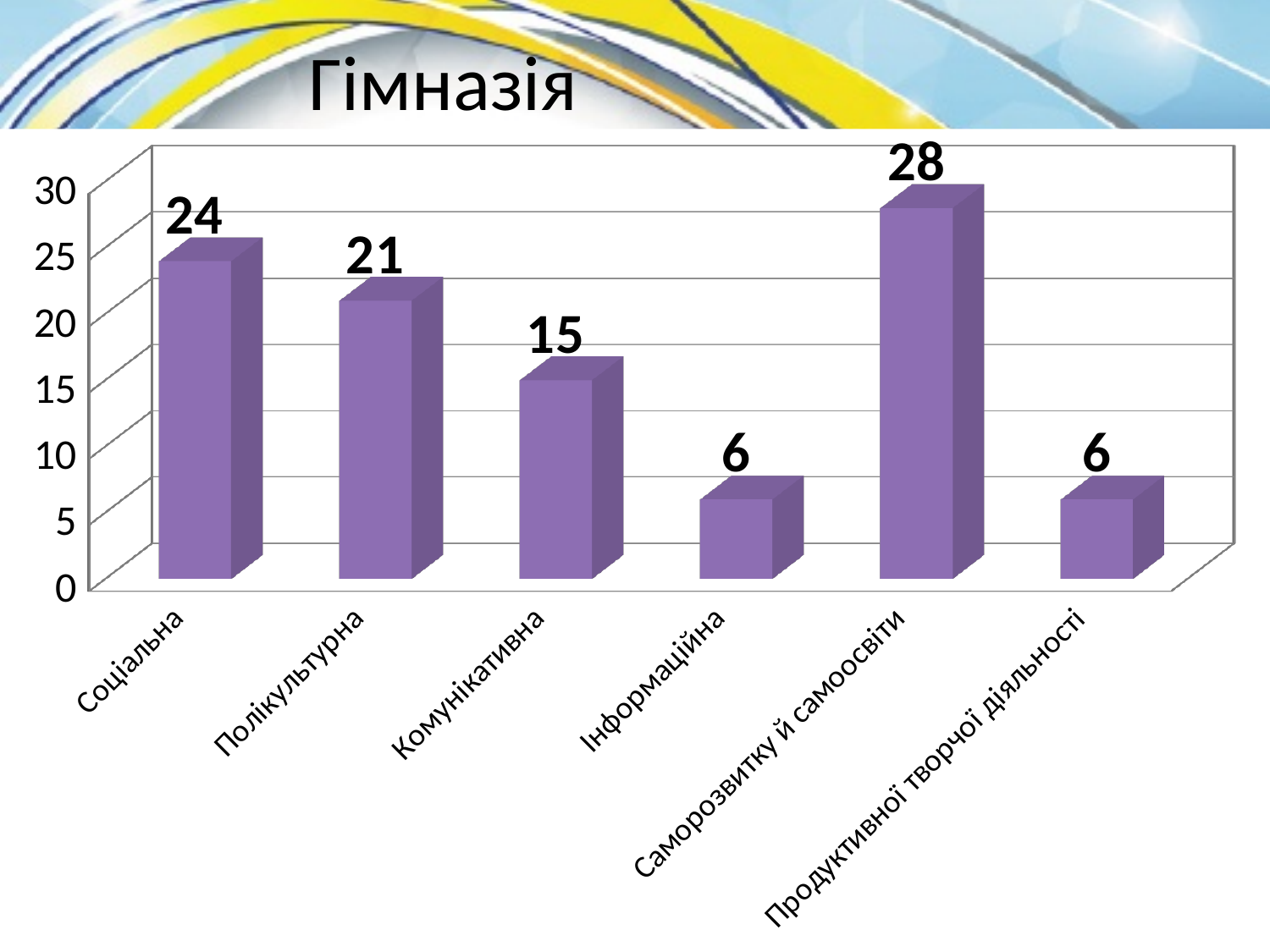
What is the difference between the values for Саморозвитку й самоосвіти and Соціальна? 4 Which is larger, the value for Соціальна or the value for Полікультурна? Соціальна What is the value for Саморозвитку й самоосвіти? 28 What kind of chart is shown on the slide? bar chart What is the difference between the values for Полікультурна and Комунікативна? 6 How many categories are shown on the chart? 6 What is the value for Соціальна? 24 What is the value for Полікультурна? 21 Is the value for Комунікативна greater or less than 20? less What is the title of the slide? Гімназія Which category has the highest value? Саморозвитку й самоосвіти What is the value for Комунікативна? 15